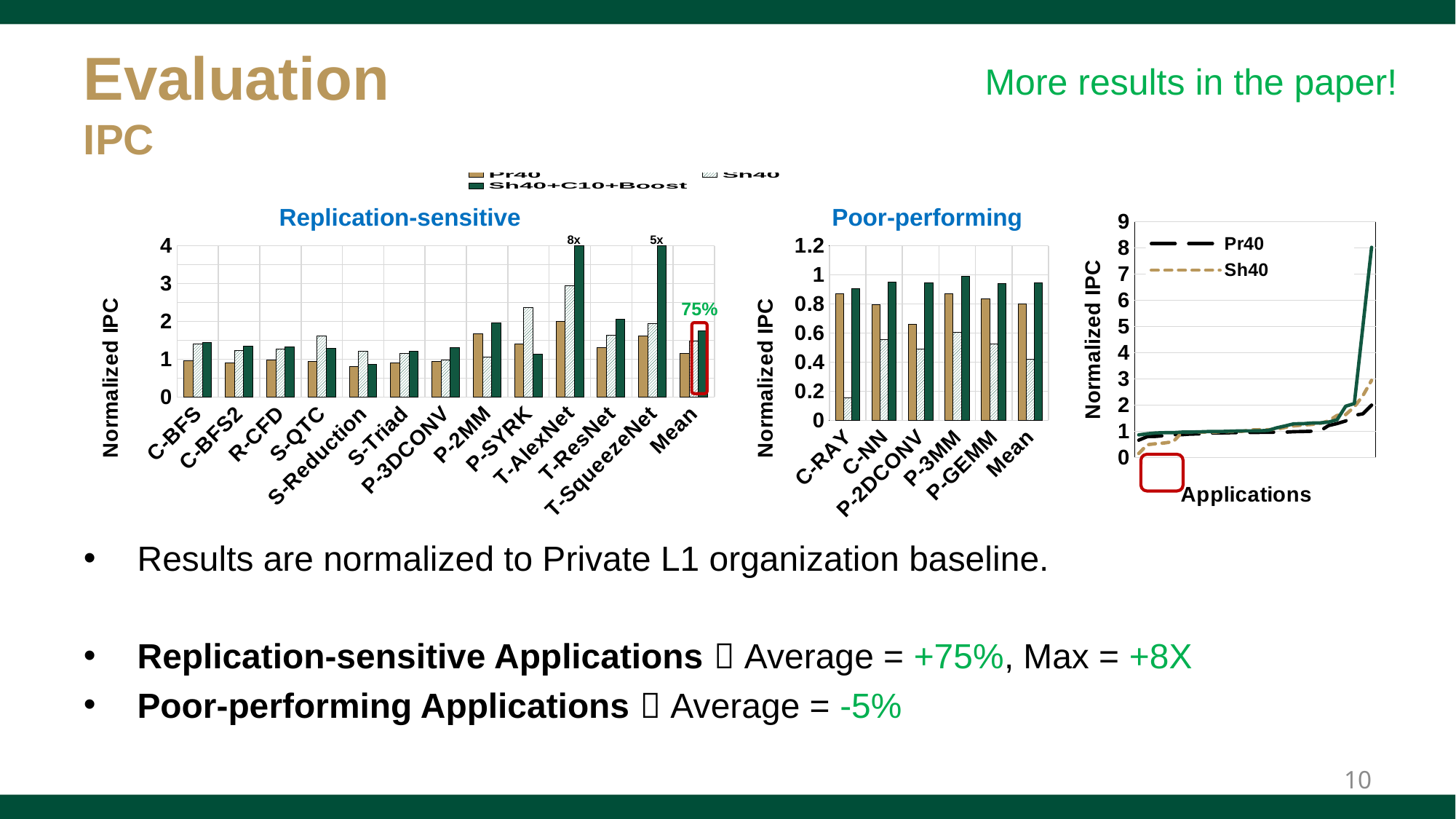
How many categories are shown on the x axis of the Replication-sensitive chart? 13 What kind of chart is the rightmost chart with the x-axis labelled Applications? line chart In the Replication-sensitive chart, what value is labelled on the Sh40+C10+Boost bar for T-SqueezeNet? 5x In the Replication-sensitive chart, what value is labelled on the Sh40+C10+Boost bar for T-AlexNet? 8x What kind of chart is the Replication-sensitive chart? bar chart In the Poor-performing chart, is the Sh40 value for C-RAY greater or less than 0.2? less In the Replication-sensitive chart, is the Sh40 value for P-SYRK greater or less than 2? greater In the Replication-sensitive chart, which category has the highest Sh40+C10+Boost value? T-AlexNet In the rightmost line chart, do the values generally rise or fall from left to right along the x axis? rise How many series does the shared legend above the bar charts list? 3 In the Poor-performing chart, which category has the lowest Sh40 value? C-RAY How many categories are shown on the x axis of the Poor-performing chart? 6